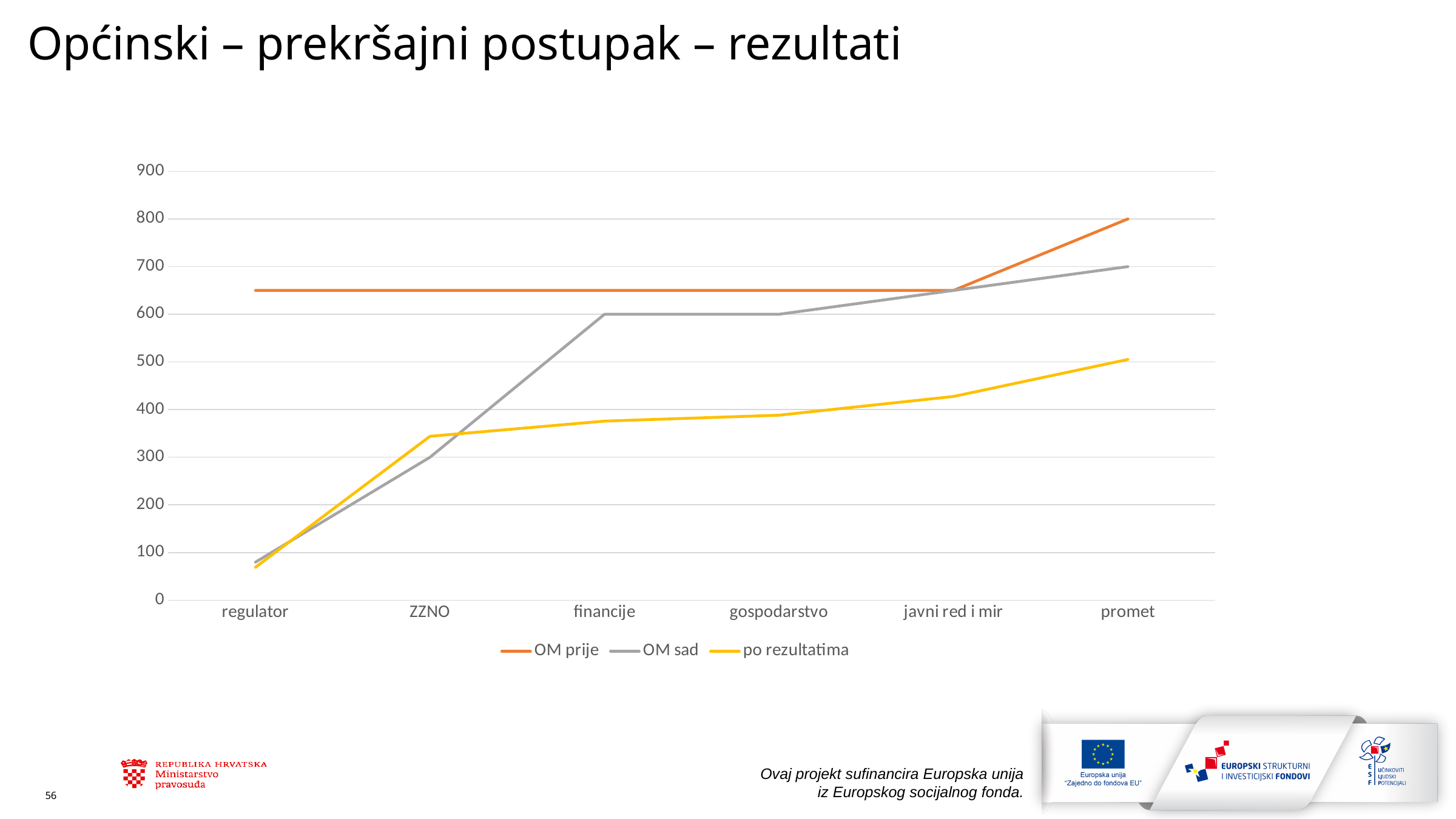
Which category has the lowest value for the OM sad series? regulator Is the value of OM prije for regulator greater or less than 600? greater Which is larger for financije: OM sad or po rezultatima? OM sad What is the value of OM sad for financije? 600 How many categories are shown on the x axis? 6 What is the value of OM prije for promet? 800 Does the po rezultatima series rise or fall from regulator to promet? rise Which category has the highest value for the po rezultatima series? promet What kind of chart is shown on the slide? line chart How many series does the legend list? 3 Is the value of po rezultatima for regulator greater or less than 100? less What is the value of OM sad for promet? 700